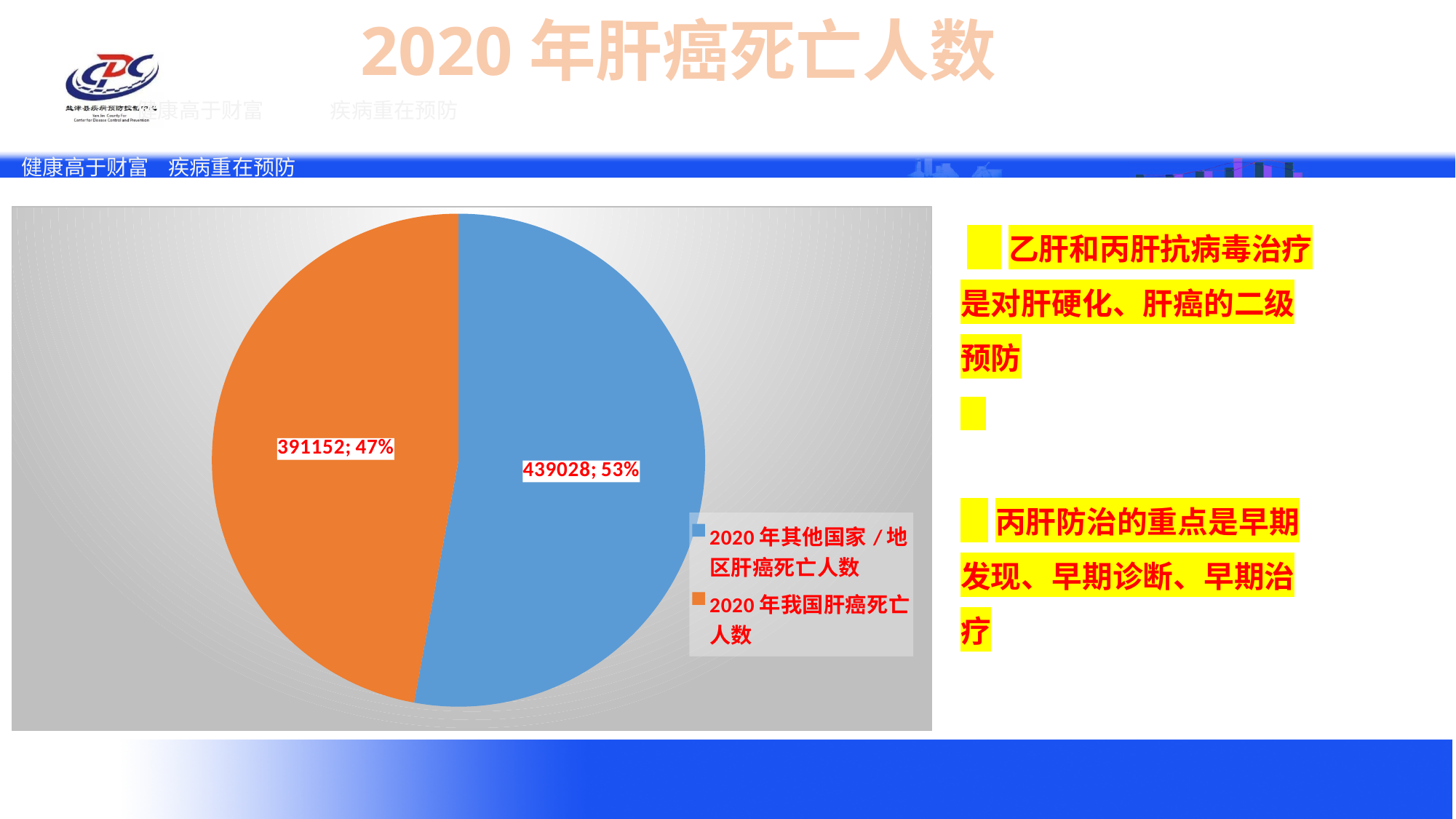
Which slice of the pie chart is the largest? 2020年其他国家／地区肝癌死亡人数 How many entries does the legend of the pie chart list? 2 What is the value shown for 2020年其他国家／地区肝癌死亡人数? 439028 What is the value shown for 2020年我国肝癌死亡人数? 391152 Which is larger: the value for 2020年我国肝癌死亡人数 or the value for 2020年其他国家／地区肝癌死亡人数? 2020年其他国家／地区肝癌死亡人数 What is the difference between the value for 2020年其他国家／地区肝癌死亡人数 and the value for 2020年我国肝癌死亡人数? 47876 What share of the pie does 2020年其他国家／地区肝癌死亡人数 represent? 53% What share of the pie does 2020年我国肝癌死亡人数 represent? 47% What kind of chart is shown on the slide? pie chart How many slices does the pie chart have? 2 Which slice of the pie chart is the smallest? 2020年我国肝癌死亡人数 What colour is the slice for 2020年我国肝癌死亡人数 in the pie chart? orange